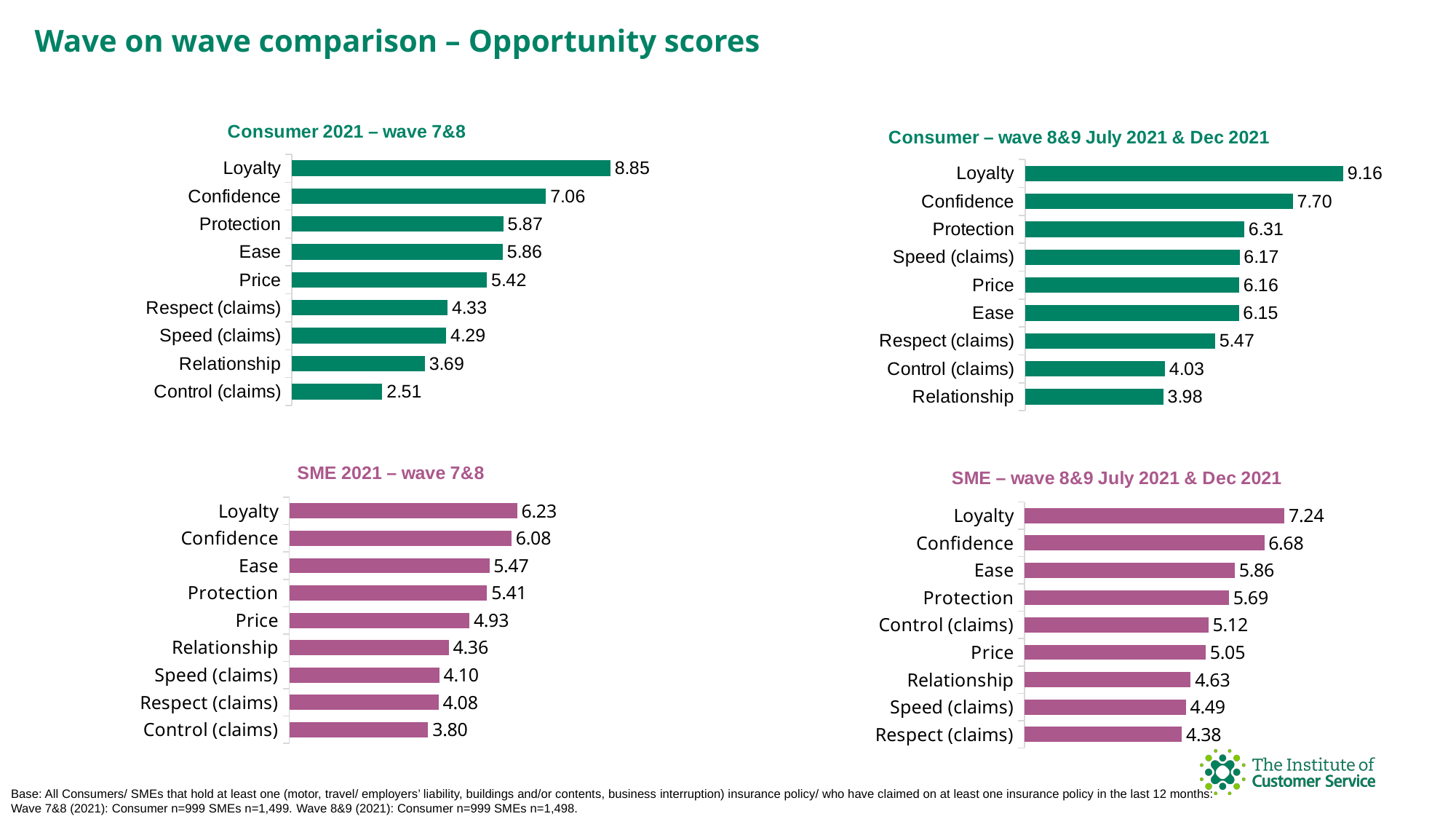
In the 'SME – wave 8&9 July 2021 & Dec 2021' chart, which category has the lowest value? Respect (claims) In the 'SME 2021 – wave 7&8' chart, what is the value for Price? 4.93 How many categories are shown in the 'Consumer – wave 8&9 July 2021 & Dec 2021' chart? 9 In the 'Consumer 2021 – wave 7&8' chart, what is the difference between Confidence and Protection? 1.19 In the 'Consumer – wave 8&9 July 2021 & Dec 2021' chart, what is the value for Speed (claims)? 6.17 In the 'SME – wave 8&9 July 2021 & Dec 2021' chart, what is the difference between Loyalty and Confidence? 0.56 In the 'Consumer 2021 – wave 7&8' chart, which category has the lowest value? Control (claims) What kind of chart is the 'SME 2021 – wave 7&8' chart? Bar chart In the 'Consumer – wave 8&9 July 2021 & Dec 2021' chart, which category has the highest value? Loyalty How many charts are shown on the slide? 4 In the 'SME 2021 – wave 7&8' chart, which is larger, Ease or Protection? Ease In the 'Consumer 2021 – wave 7&8' chart, what is the value for Loyalty? 8.85